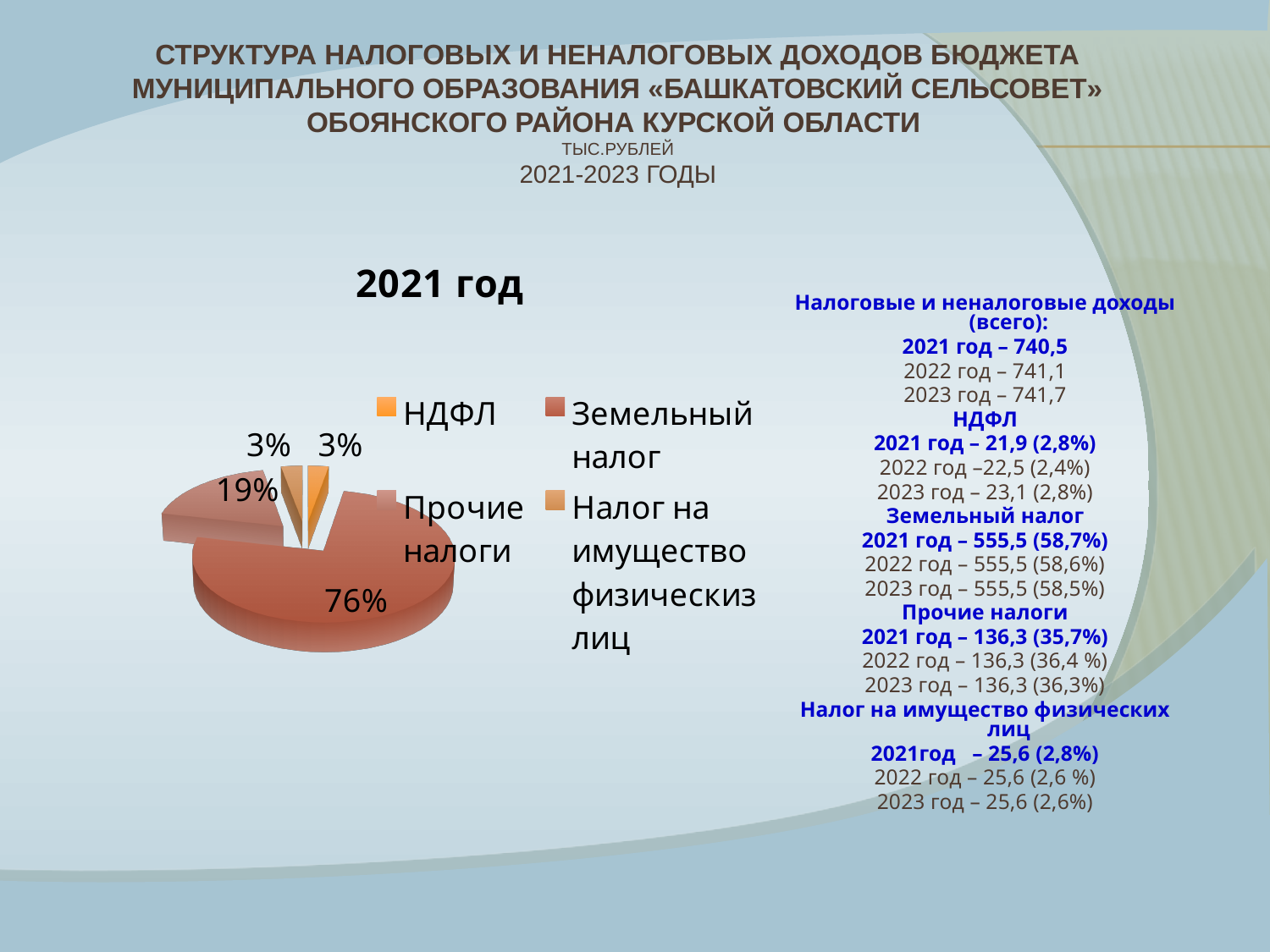
By how many percentage points does the Земельный налог slice exceed the Прочие налоги slice? 57 What share of the pie does НДФЛ have? 3% How many slices does the pie chart have? 4 Which category has the largest slice in the pie chart? Земельный налог What share of the pie does Прочие налоги have? 19% Which is larger in the pie chart, Земельный налог or Прочие налоги? Земельный налог What kind of chart is shown on the slide? pie chart What colour is the Земельный налог slice in the pie chart? red What is the smallest percentage label shown on the pie chart? 3% What share of the pie does Земельный налог have? 76% What is the title of the pie chart? 2021 год How many entries does the legend of the pie chart list? 4